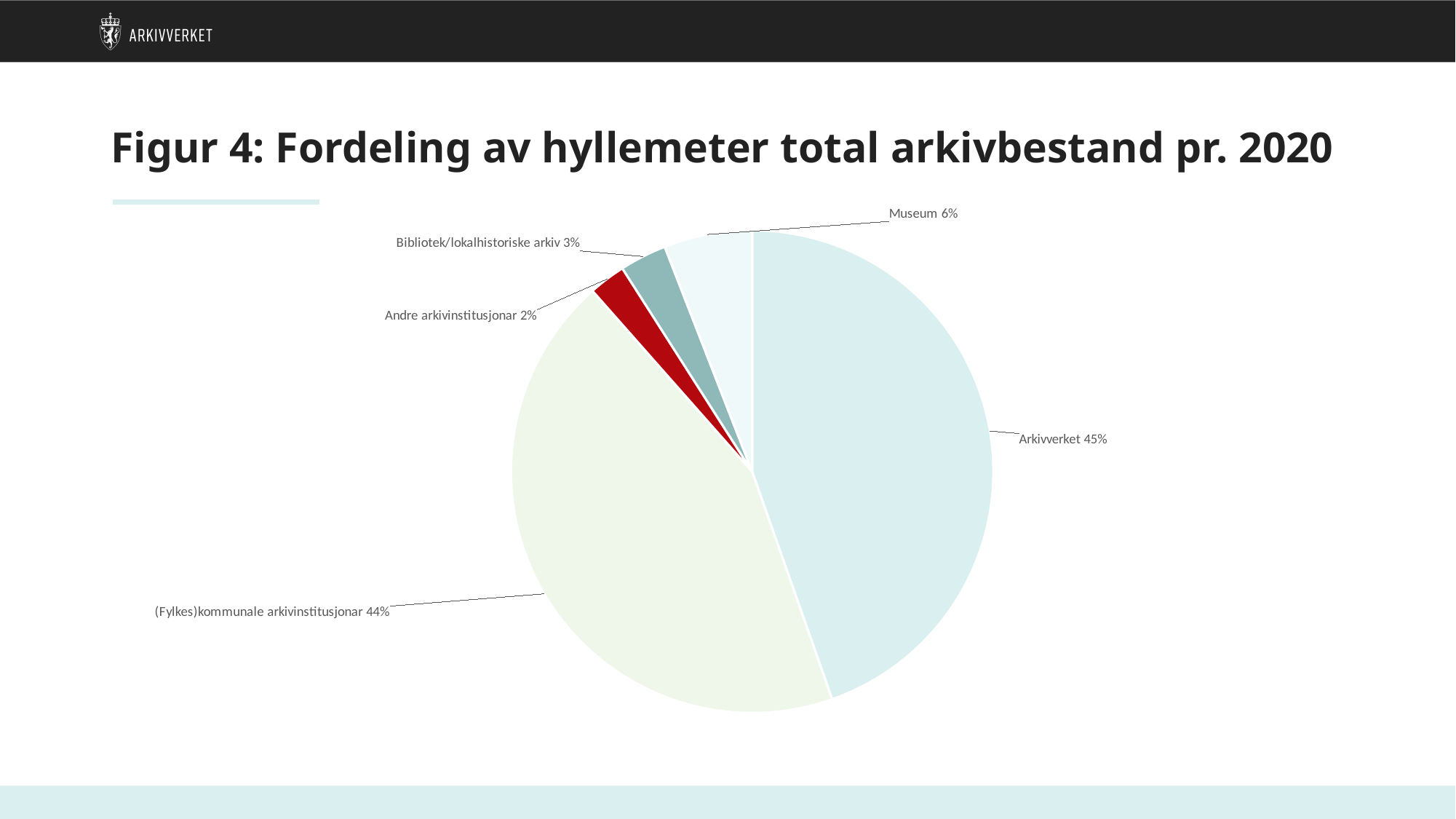
What share of the pie does Arkivverket hold? 45% What is the value shown for Andre arkivinstitusjonar? 2% How many slices does the pie chart have? 5 Which is larger, the share for Museum or the share for Andre arkivinstitusjonar? Museum What is the value shown for Museum? 6% What type of chart is shown on the slide? Pie chart What is the difference in percentage points between Museum and Bibliotek/lokalhistoriske arkiv? 3 What is the value shown for Bibliotek/lokalhistoriske arkiv? 3% What is the title of the chart on the slide? Figur 4: Fordeling av hyllemeter total arkivbestand pr. 2020 What share of the pie does (Fylkes)kommunale arkivinstitusjonar hold? 44% Which category has the smallest slice of the pie? Andre arkivinstitusjonar Which category has the largest slice of the pie? Arkivverket